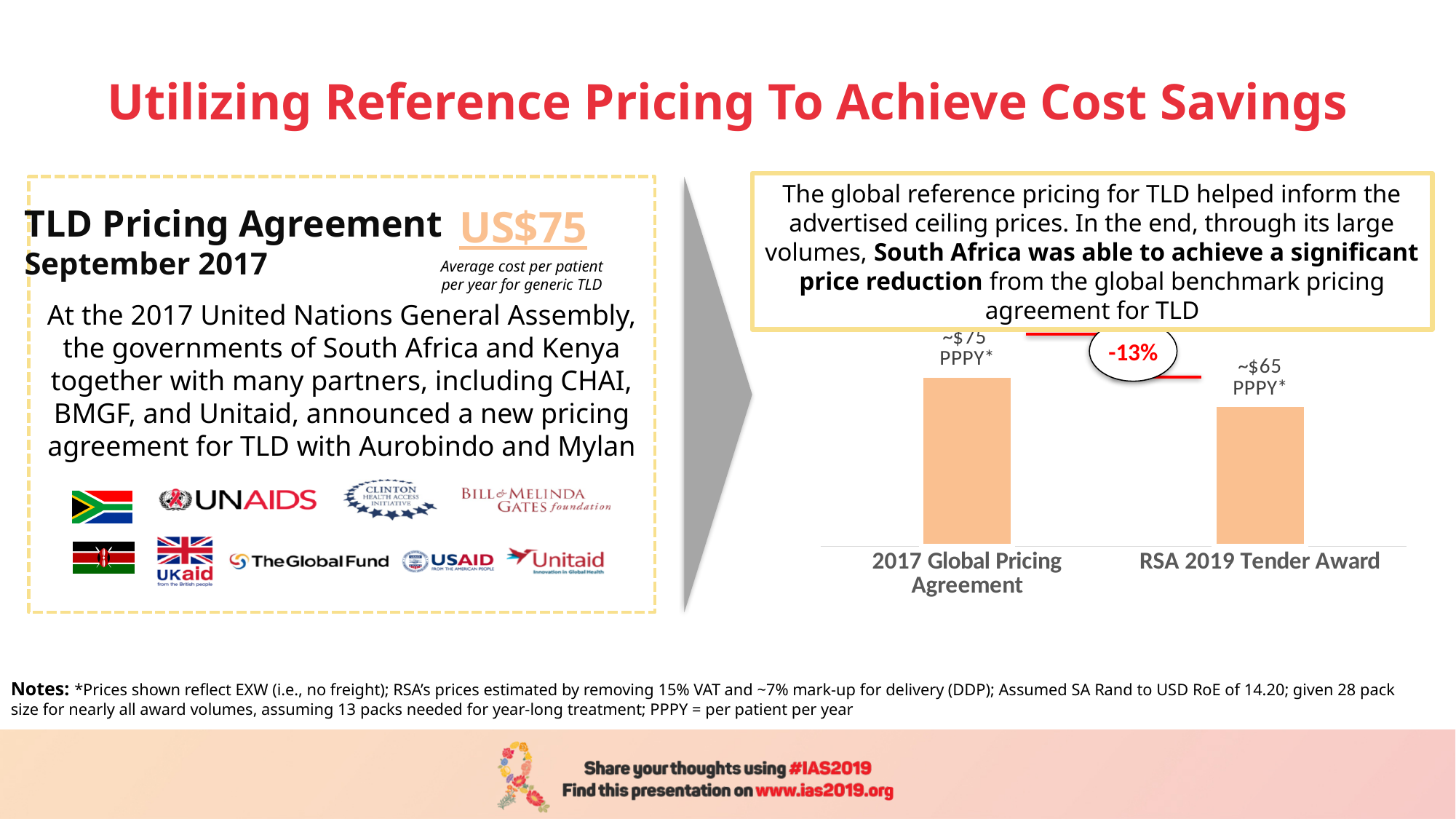
Which category has the taller bar, 2017 Global Pricing Agreement or RSA 2019 Tender Award? 2017 Global Pricing Agreement Which category has the lowest value in the chart? RSA 2019 Tender Award What percentage change is annotated between the two bars in the chart? -13% Do the bar values rise or fall from 2017 Global Pricing Agreement to RSA 2019 Tender Award? fall Which category has the highest value in the chart? 2017 Global Pricing Agreement What is the data label on the bar for 2017 Global Pricing Agreement? ~$75 PPPY* What are the two category labels on the x axis of the chart? 2017 Global Pricing Agreement; RSA 2019 Tender Award How many bars does the chart on the right show? 2 What is the data label on the bar for RSA 2019 Tender Award? ~$65 PPPY* What kind of chart is shown on the right side of the slide? bar chart